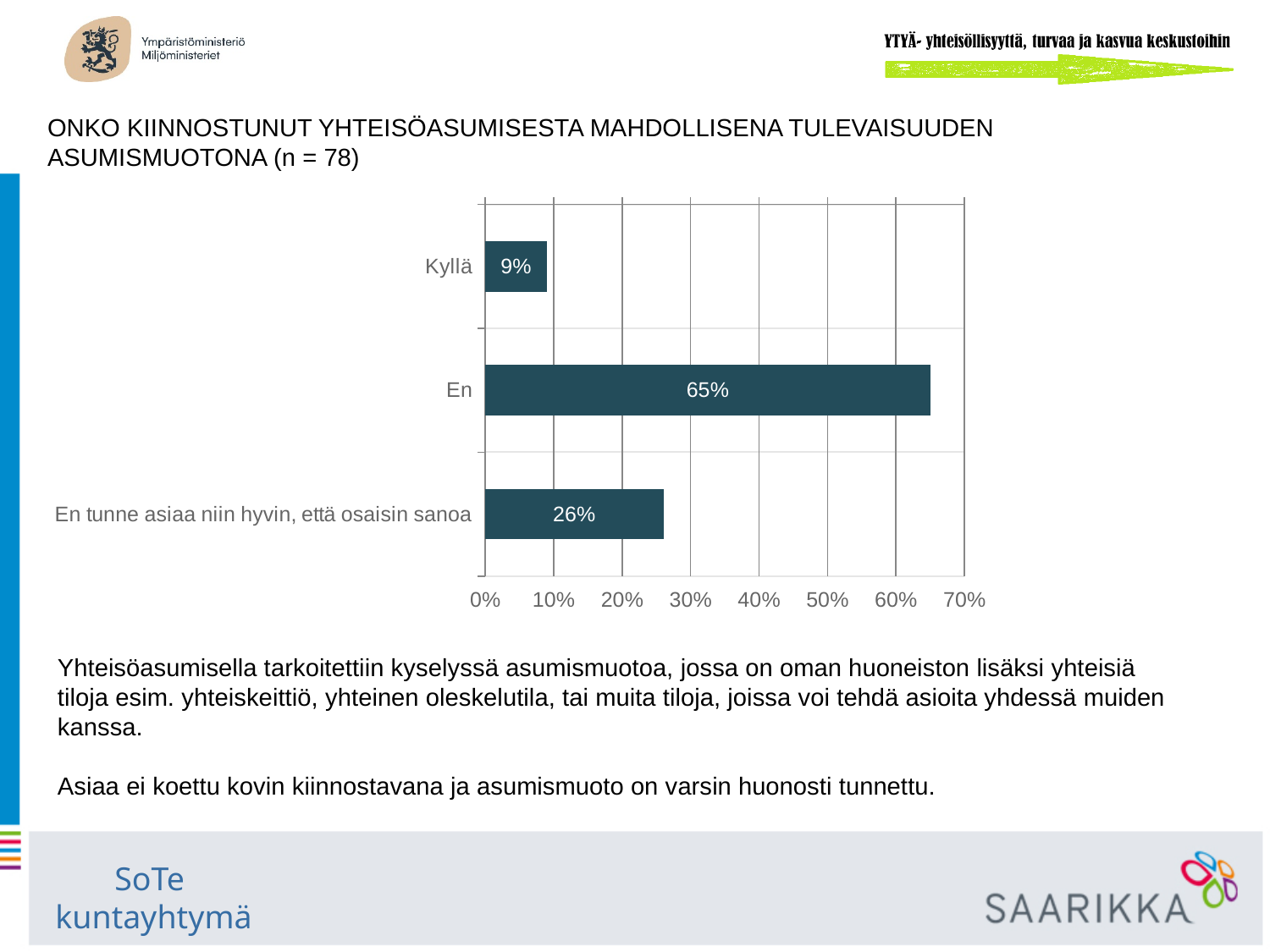
What is the value for "En tunne asiaa niin hyvin, että osaisin sanoa"? 26% What is the difference between the values for "En" and "Kyllä"? 56% What is the difference between the values for "En" and "En tunne asiaa niin hyvin, että osaisin sanoa"? 39% What kind of chart is shown on the slide? bar chart Which category has the lowest value? Kyllä What is the value for "Kyllä"? 9% Which category has the highest value? En Which is larger, the value for "Kyllä" or the value for "En tunne asiaa niin hyvin, että osaisin sanoa"? En tunne asiaa niin hyvin, että osaisin sanoa What is the value for "En"? 65% Is the value for "En" greater or less than 60%? greater What is the highest value shown on the x axis of the chart? 70% How many categories are shown in the chart? 3